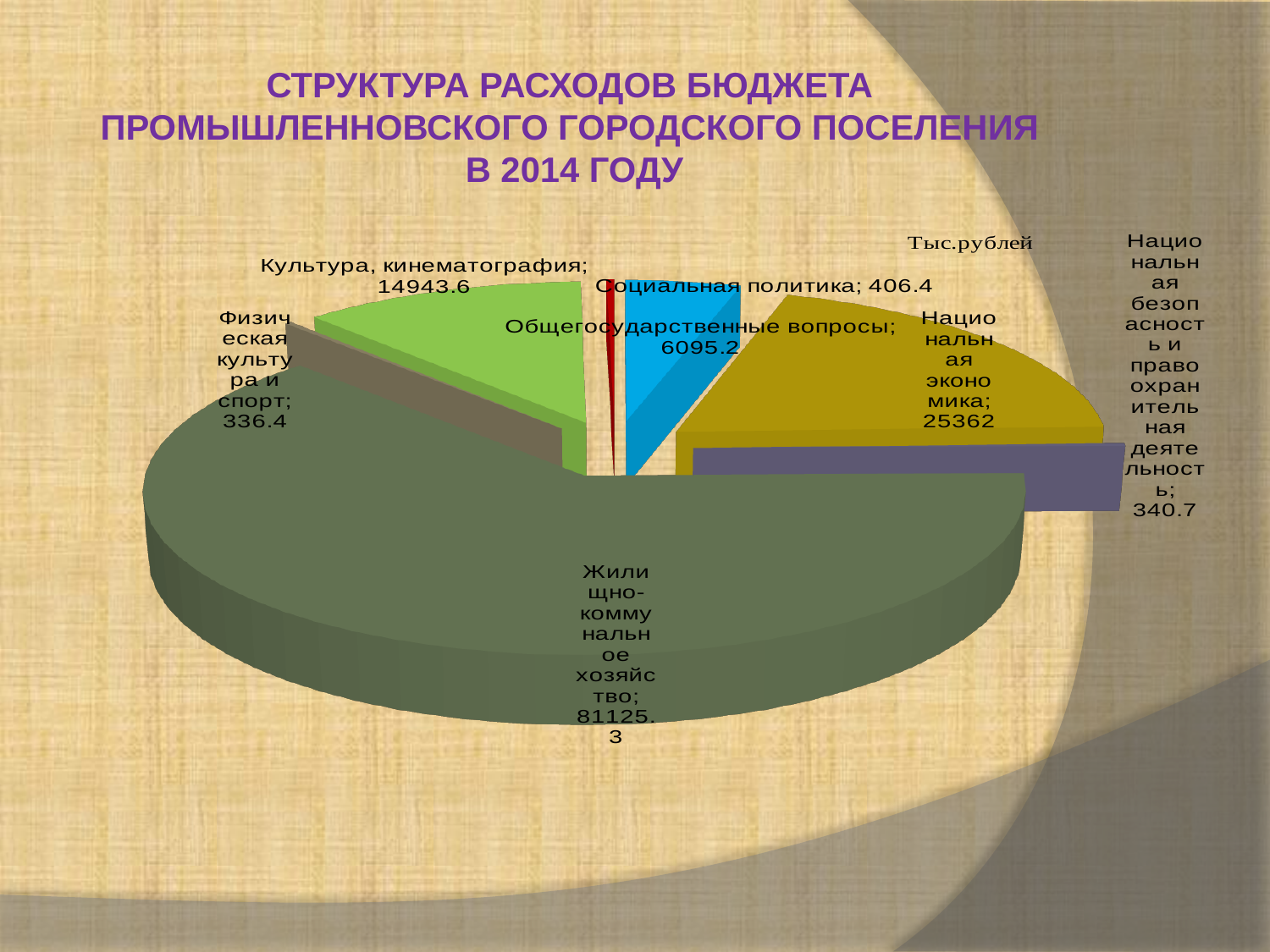
In what units are the values on the chart given? Тыс.рублей What kind of chart is shown on the slide? pie chart What is the difference between Общегосударственные вопросы and Социальная политика? 5688.8 Which is larger: Национальная безопасность и правоохранительная деятельность or Физическая культура и спорт? Национальная безопасность и правоохранительная деятельность What is the value for Культура, кинематография? 14943.6 What is the value for Социальная политика? 406.4 What is the value for Жилищно-коммунальное хозяйство? 81125.3 Which category has the smallest value? Физическая культура и спорт How many categories does the pie chart show? 7 What is the difference between Национальная экономика and Культура, кинематография? 10418.4 Which category has the largest value? Жилищно-коммунальное хозяйство What is the value for Национальная экономика? 25362